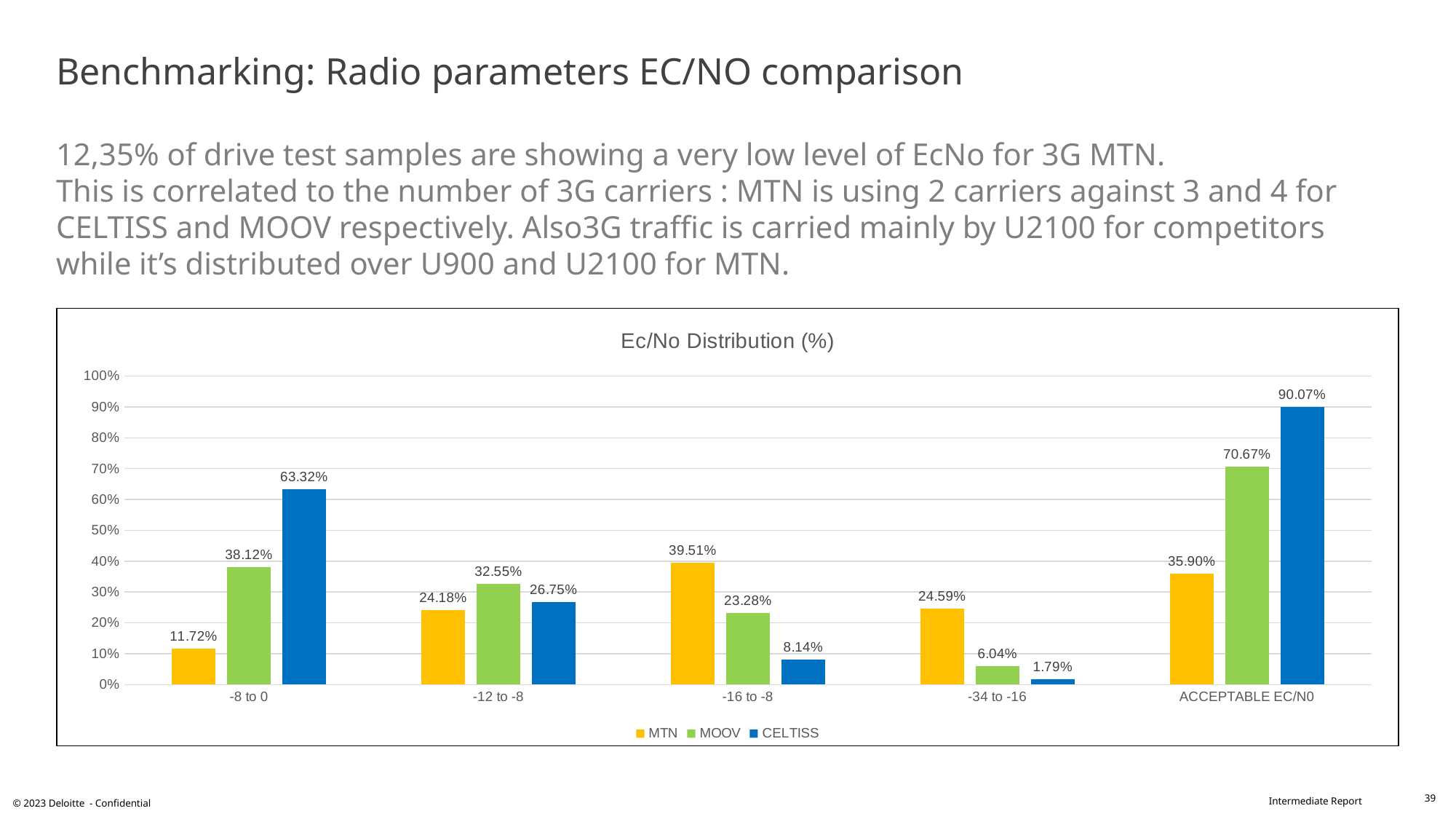
What is the value for CELTISS in the -8 to 0 category? 63.32% How many series does the legend list? 3 How many categories are shown on the x axis? 5 What kind of chart is shown on the slide? bar chart What is the value for MTN in the -16 to -8 category? 39.51% Which is larger in the -12 to -8 category, the MOOV value or the CELTISS value? MOOV What is the title of the chart? Ec/No Distribution (%) Which series has the highest value in the ACCEPTABLE EC/N0 category? CELTISS What is the value for MOOV in the ACCEPTABLE EC/N0 category? 70.67% Which series has the lowest value in the -34 to -16 category? CELTISS What is the difference between the CELTISS and MTN values in the -8 to 0 category? 51.60% Is the value for MTN in the ACCEPTABLE EC/N0 category greater or less than 40%? less